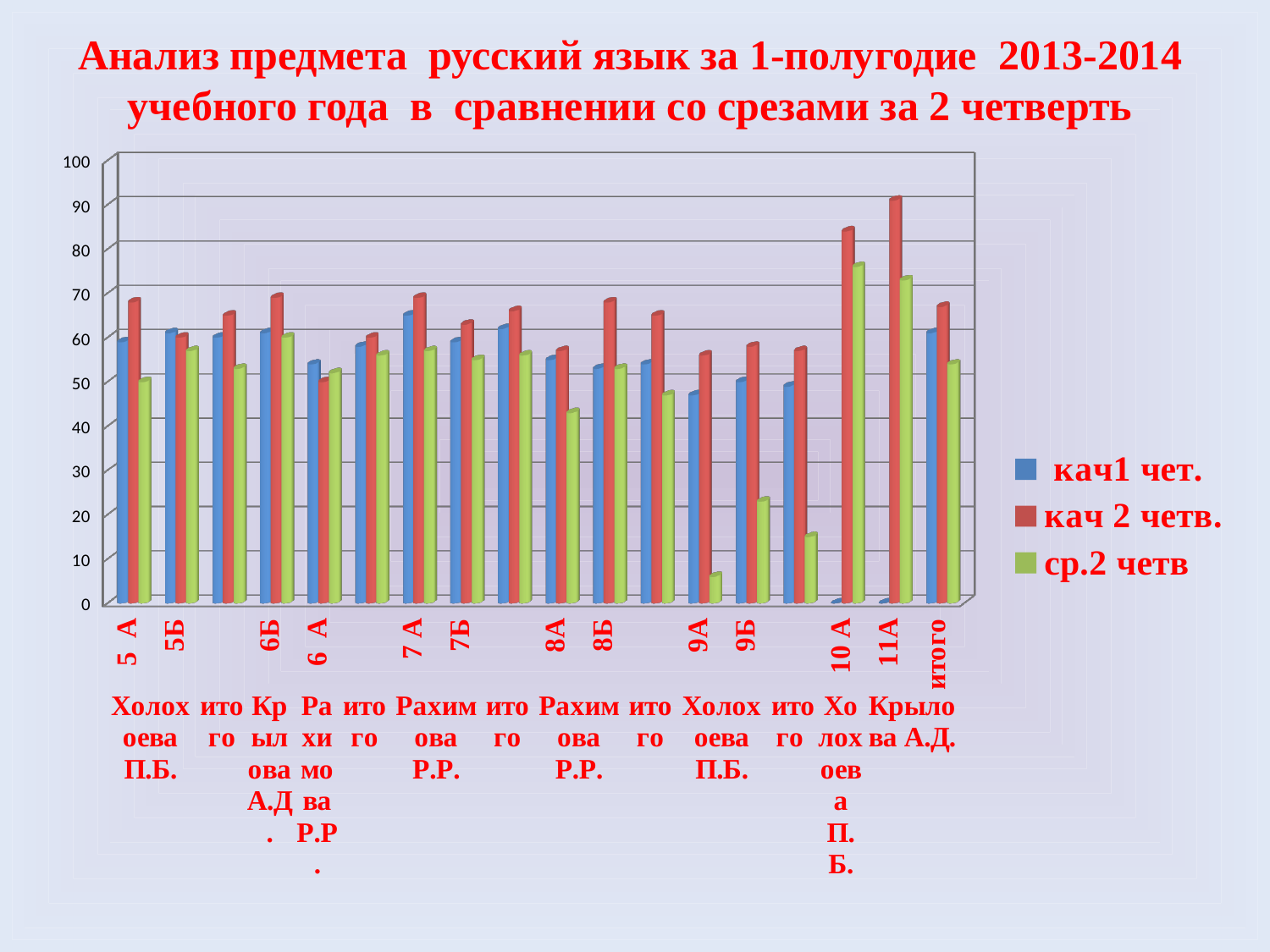
For 8А, which is larger: кач 2 четв. or ср.2 четв? кач 2 четв. Is the value of кач 2 четв. for 10 А greater or less than 80? greater Which series is shown in green in the legend? ср.2 четв What kind of chart is shown on the slide? bar chart For 9А, which is larger: кач 2 четв. or ср.2 четв? кач 2 четв. Which series is shown in red in the legend? кач 2 четв. Which category has the lowest value for the series ср.2 четв? 9А Is the value of ср.2 четв for 9Б greater or less than 30? less Is the value of кач 2 четв. for 11А greater or less than 80? greater How many series does the legend list? 3 Which category has the highest value for the series кач 2 четв.? 11А